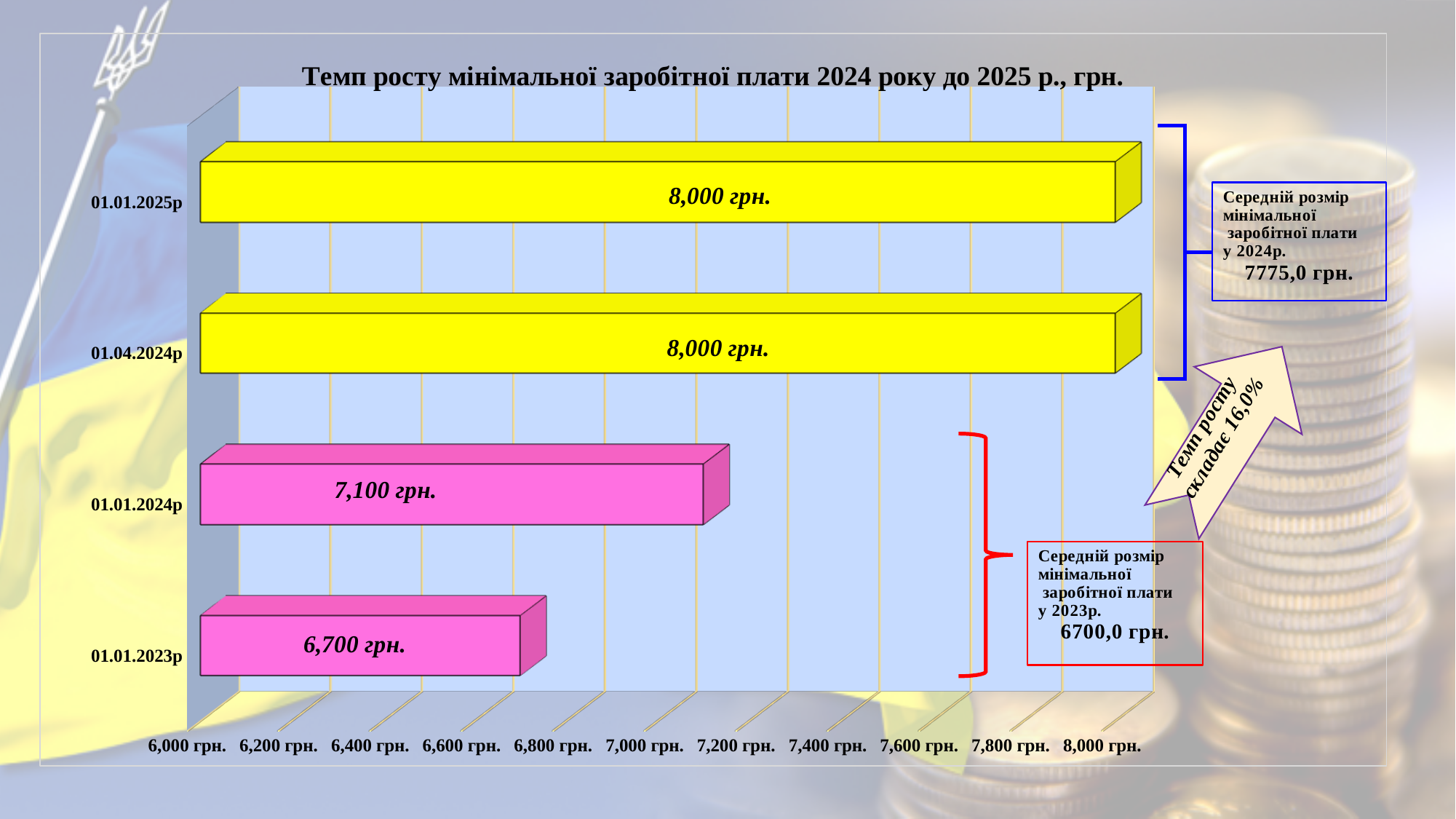
What is the value for 01.01.2025р? 8,000 грн. Is the value for 01.01.2024р greater or less than 7,000 грн.? greater Which category has the lowest value? 01.01.2023р What is the difference between the values for 01.04.2024р and 01.01.2024р? 900 грн. Which is larger, the value for 01.01.2024р or the value for 01.01.2023р? 01.01.2024р How many categories are shown on the chart? 4 What is the value for 01.01.2024р? 7,100 грн. What is the value for 01.04.2024р? 8,000 грн. What is the difference between the values for 01.01.2024р and 01.01.2023р? 400 грн. What kind of chart is shown on the slide? bar chart What is the title of the chart? Темп росту мінімальної заробітної плати 2024 року до 2025 р., грн. What is the value for 01.01.2023р? 6,700 грн.